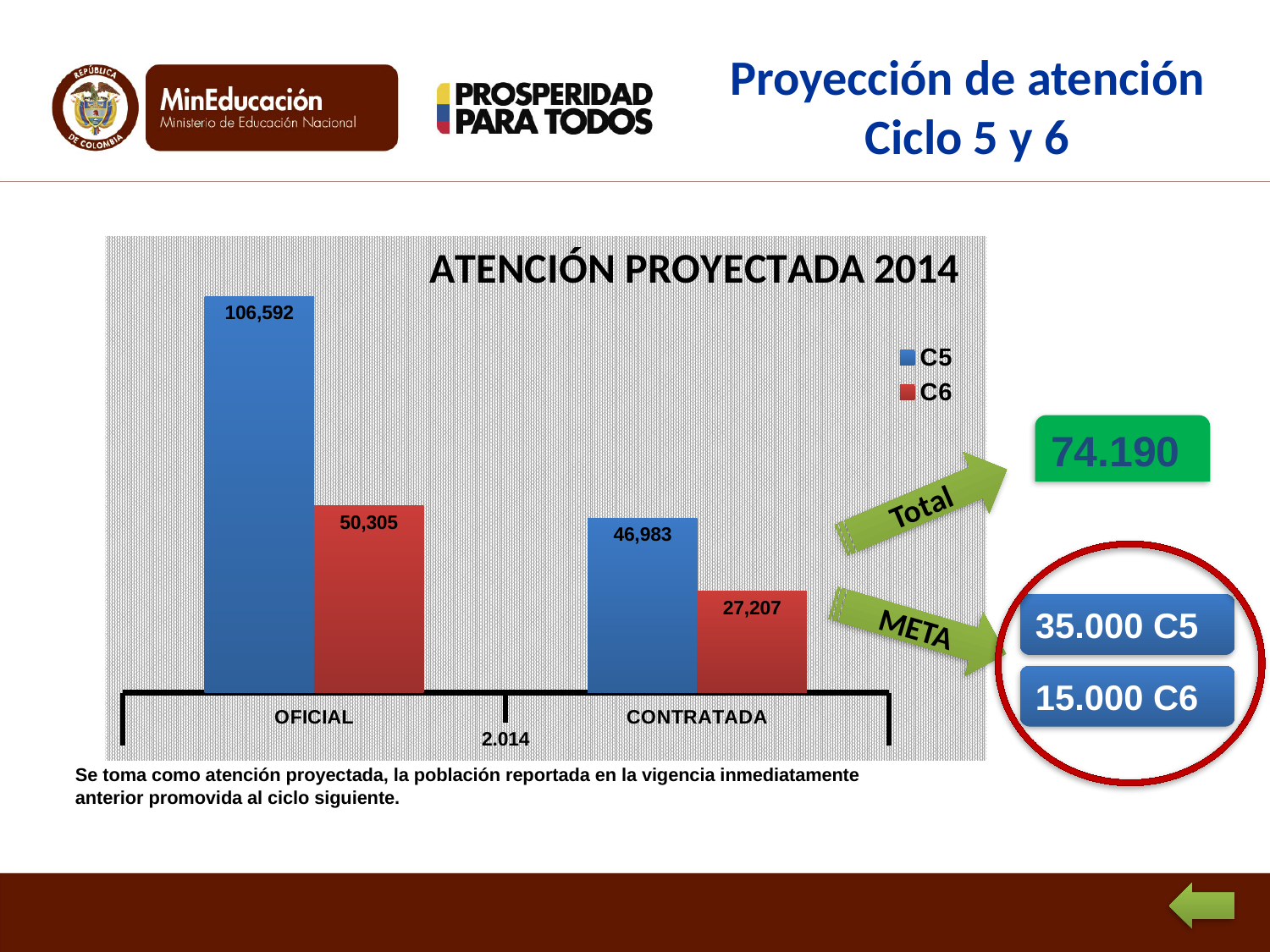
What is the C6 value for OFICIAL? 50,305 Which bar in the chart has the highest value? OFICIAL C5 What is the C5 value for OFICIAL in the ATENCIÓN PROYECTADA 2014 chart? 106,592 What is the difference between the C5 values for OFICIAL and CONTRATADA? 59,609 What is the difference between the C5 and C6 values for OFICIAL? 56,287 What kind of chart is shown on the slide? Bar chart How many series does the legend list? 2 What is the C5 value for CONTRATADA? 46,983 What is the title of the chart? ATENCIÓN PROYECTADA 2014 Which bar in the chart has the lowest value? CONTRATADA C6 Which is larger, the C6 value for OFICIAL or the C5 value for CONTRATADA? C6 value for OFICIAL What is the C6 value for CONTRATADA? 27,207